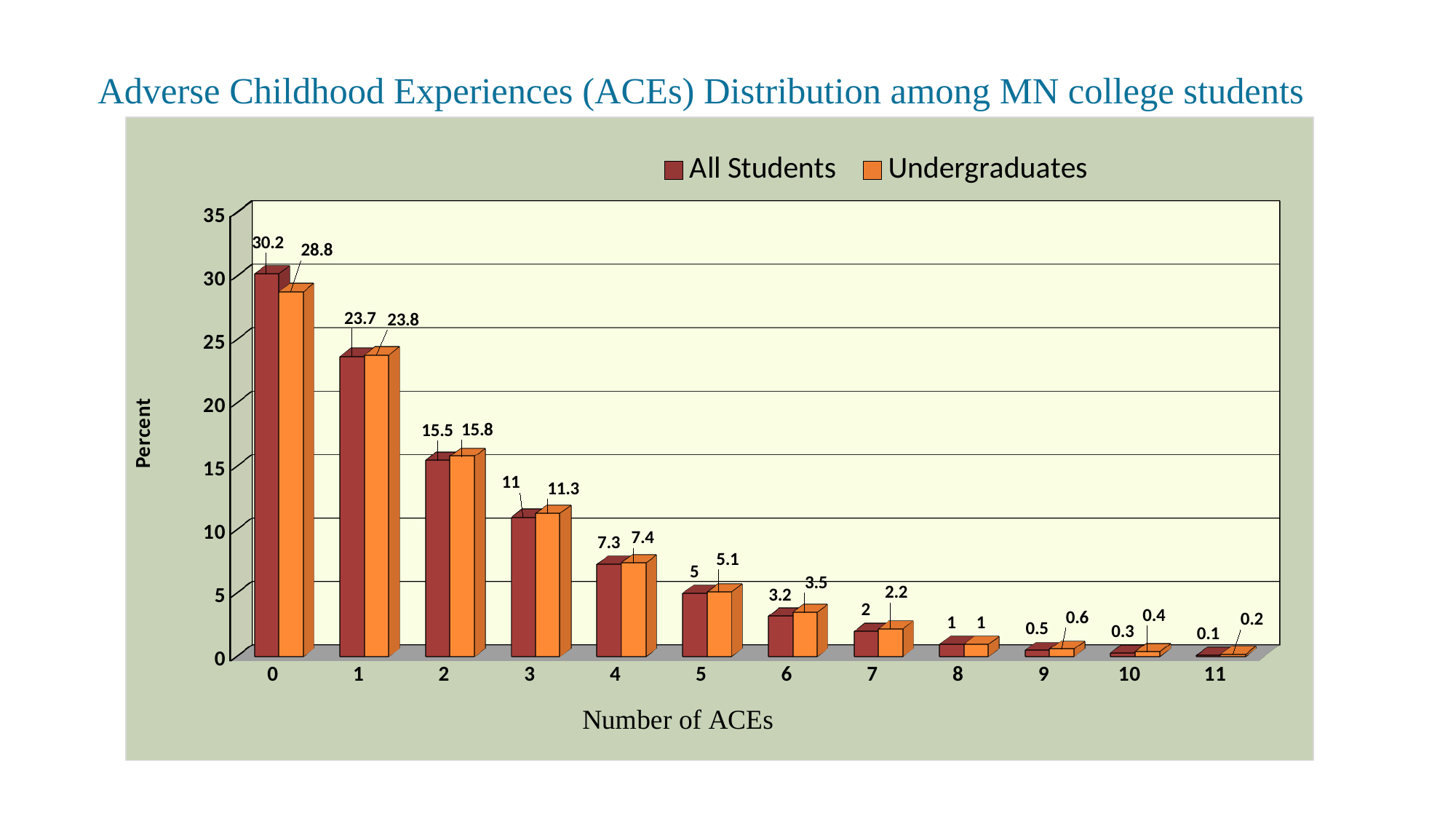
Which number of ACEs has the highest value for Undergraduates? 0 Do the values for All Students rise or fall as the number of ACEs increases? Fall How many series does the legend list? 2 What is the difference between All Students and Undergraduates at 0 ACEs? 1.4 What kind of chart is shown? Bar chart What is the value for All Students at 6 ACEs? 3.2 Which is larger at 5 ACEs: All Students or Undergraduates? Undergraduates Which number of ACEs has the lowest value for All Students? 11 What is the value for All Students at 0 ACEs? 30.2 How many number-of-ACEs categories are shown on the x axis? 12 What is the label of the y axis? Percent What is the value for Undergraduates at 2 ACEs? 15.8